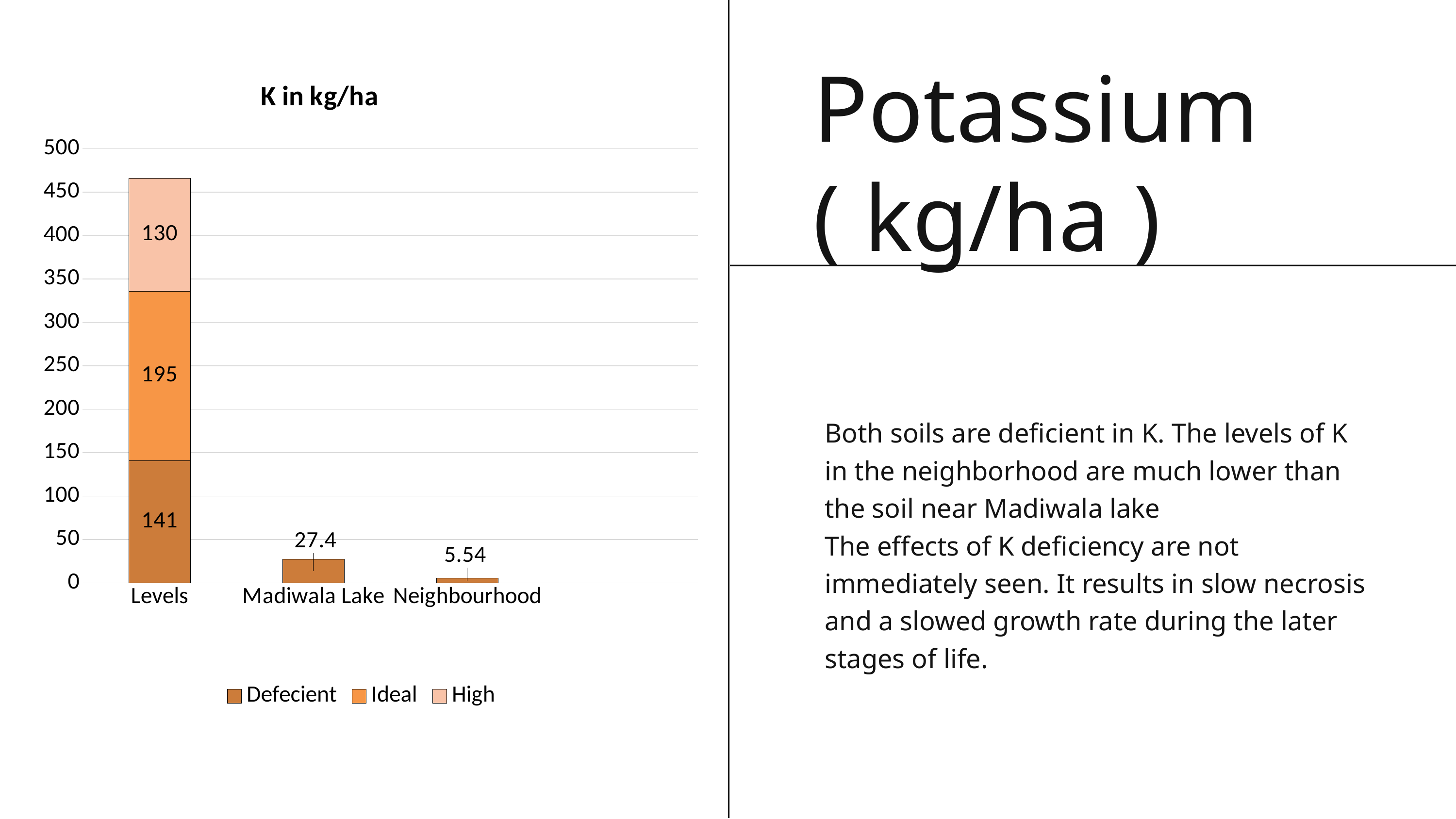
How many categories are shown on the x axis of the chart? 3 What is the High value for the Levels bar? 130 What is the value for Neighbourhood? 5.54 What is the total of the stacked Levels bar? 466 How many series does the chart legend list? 3 What is the Defecient value for the Levels bar? 141 What kind of chart is shown on the slide? stacked bar chart What is the Ideal value for the Levels bar? 195 What is the value for Madiwala Lake? 27.4 What is the difference between the Madiwala Lake value and the Neighbourhood value? 21.86 What is the title of the chart? K in kg/ha Which category has the lowest value in the chart? Neighbourhood